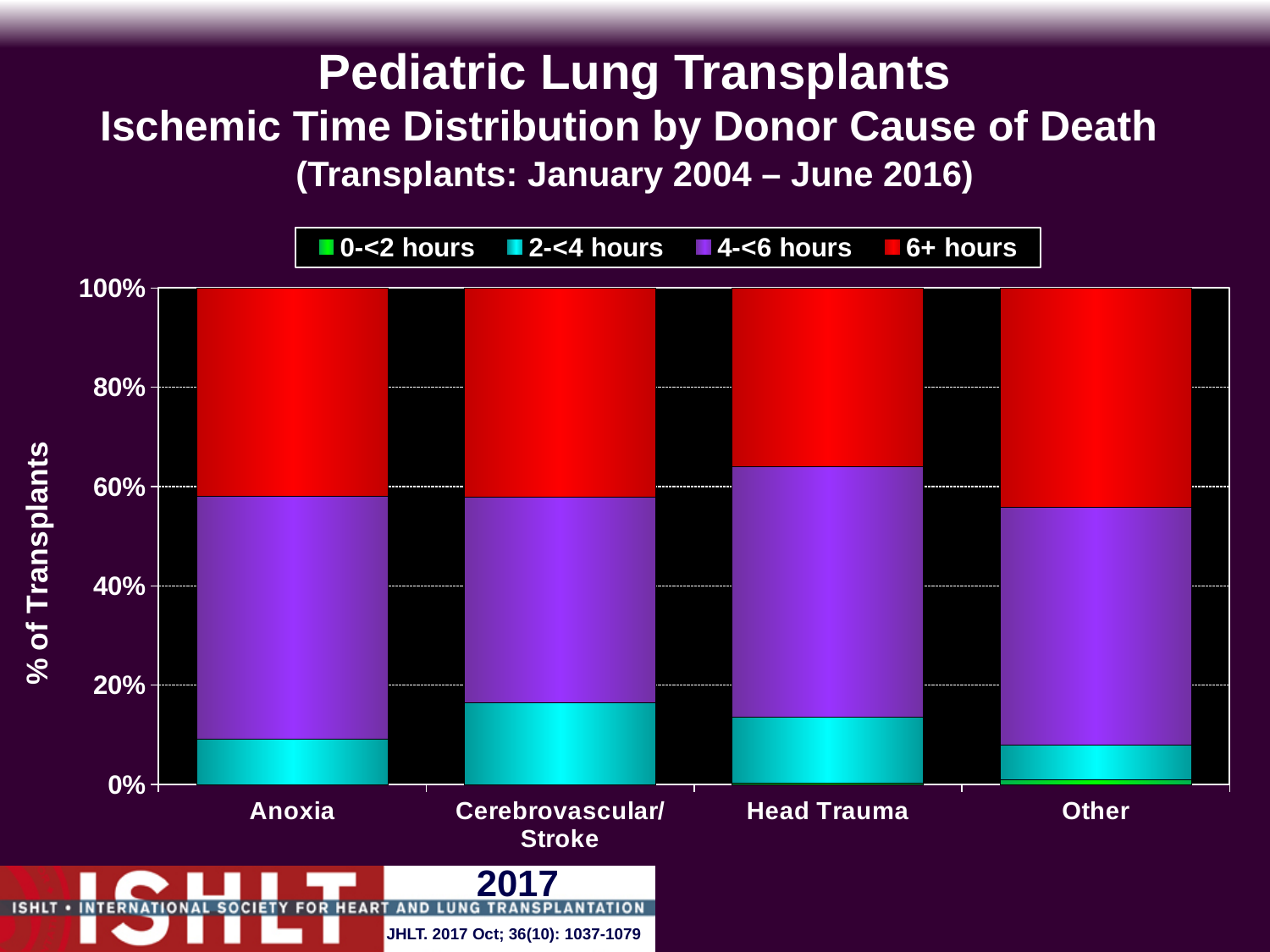
Which donor cause of death category has the smallest 6+ hours share? Head Trauma What kind of chart is shown on the slide? Stacked bar chart Is the 6+ hours share for Head Trauma greater or less than 40%? less Is the 6+ hours share for Other greater or less than 20%? greater How many donor cause of death categories are shown on the x axis? 4 Which has the larger 2-<4 hours share, Anoxia or Cerebrovascular/Stroke? Cerebrovascular/Stroke Which donor cause of death category has the largest 2-<4 hours share? Cerebrovascular/Stroke Is the 2-<4 hours share for Cerebrovascular/Stroke greater or less than 20%? less What is the label on the y axis of the chart? % of Transplants Which colour represents the 6+ hours series in the legend? Red How many series does the legend list? 4